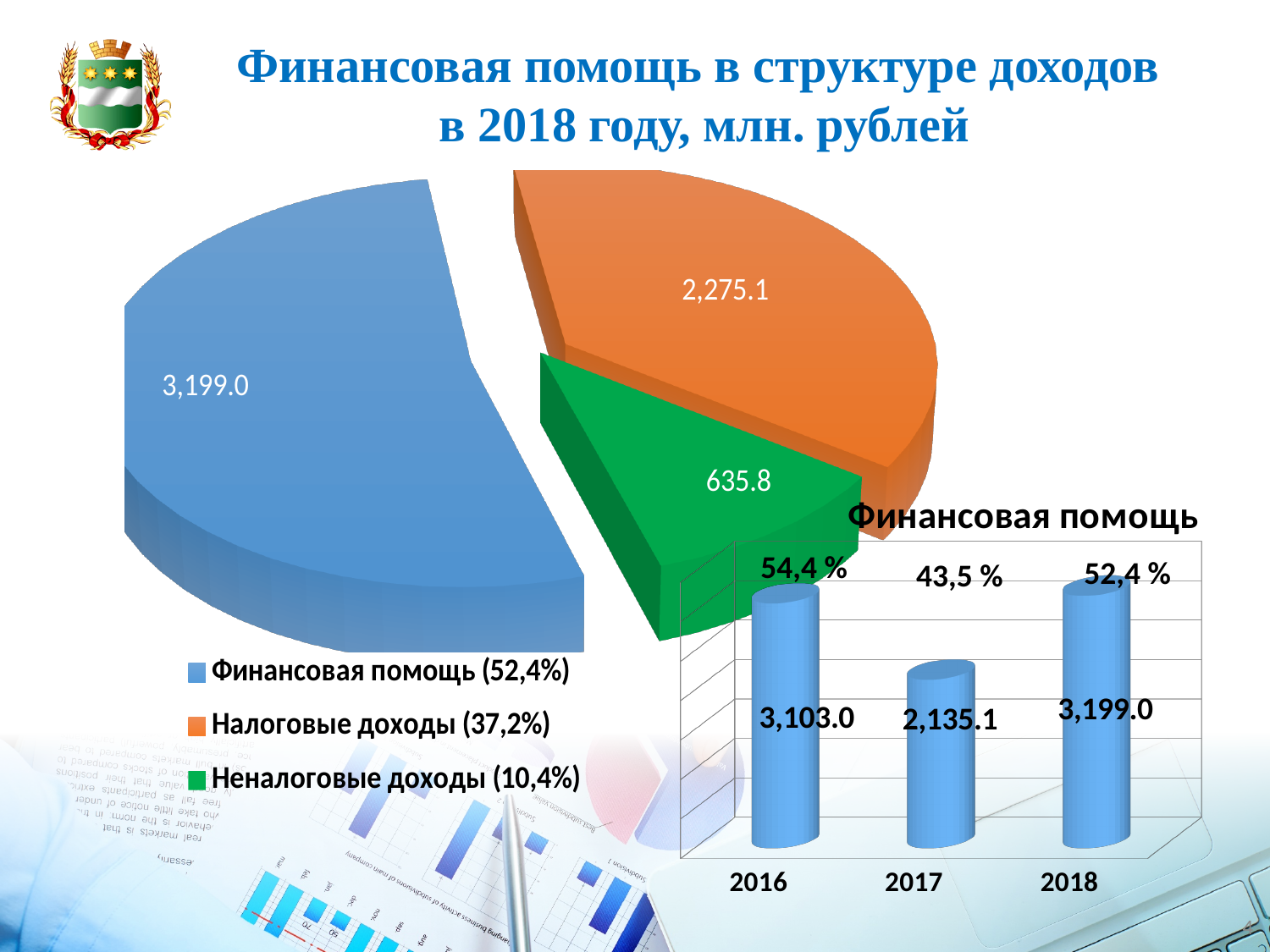
In the bar chart titled Финансовая помощь, what is the value for 2017? 2,135.1 In the bar chart titled Финансовая помощь, which year has the lowest value? 2017 In the bar chart titled Финансовая помощь, what percentage is shown above the 2016 bar? 54,4 % How many categories does the pie chart legend list? 3 What kind of chart is the one titled Финансовая помощь in the lower right? bar chart In the pie chart, which category has the largest slice? Финансовая помощь In the pie chart, what is the value for Налоговые доходы? 2,275.1 In the pie chart, what is the difference between Финансовая помощь and Налоговые доходы? 923.9 In the pie chart, what share does Налоговые доходы have according to the legend? 37,2% In the pie chart, which category has the smallest slice? Неналоговые доходы In the pie chart, what is the value for Неналоговые доходы? 635.8 In the bar chart titled Финансовая помощь, what is the difference between the 2018 and 2016 values? 96.0